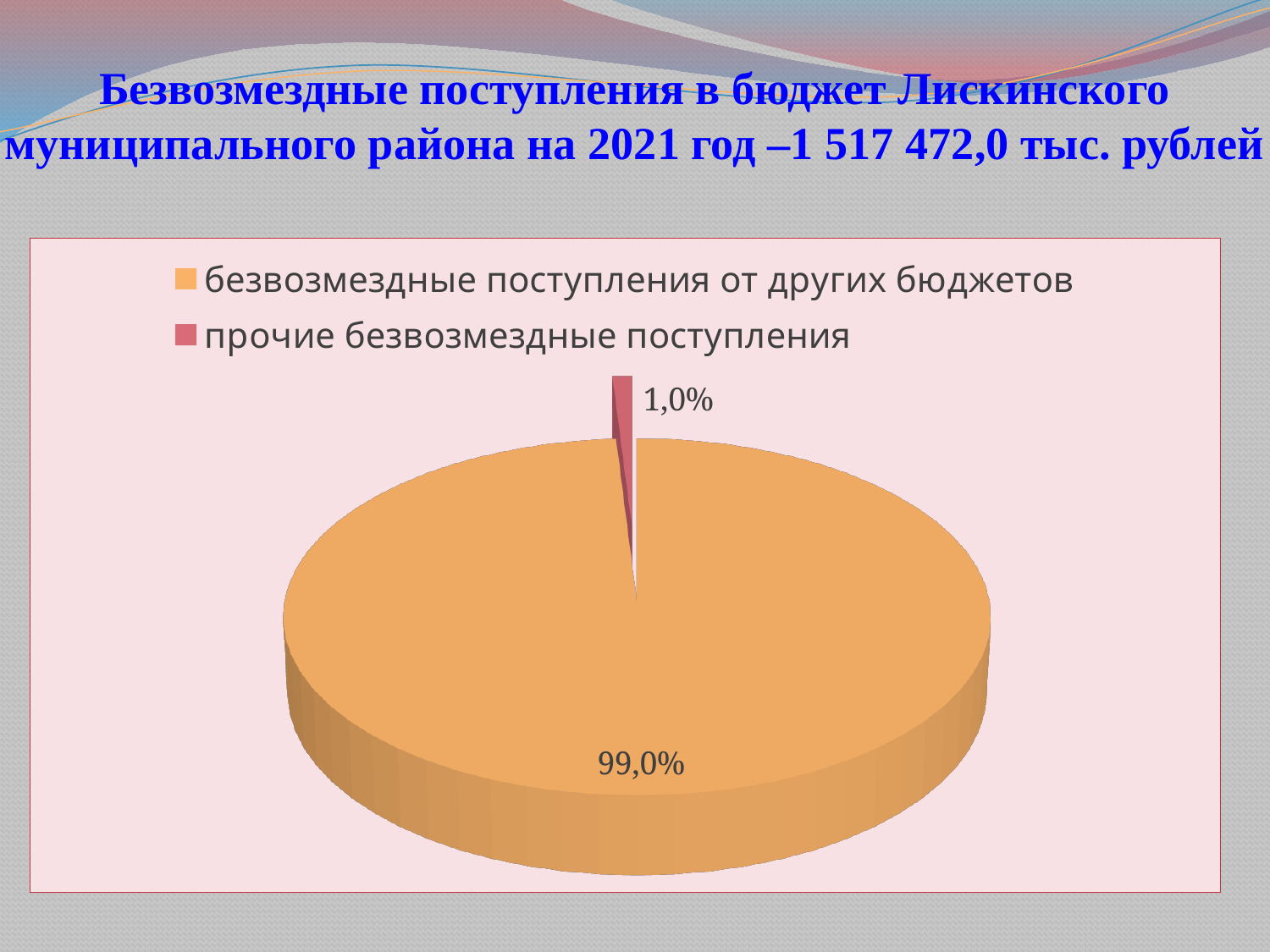
What kind of chart is shown on the slide? pie chart What total amount in thousand rubles is stated in the slide title for 2021? 1 517 472,0 тыс. рублей Which category has the largest slice of the pie? безвозмездные поступления от других бюджетов What share of the pie does 'безвозмездные поступления от других бюджетов' have? 99,0% What colour is the slice for 'прочие безвозмездные поступления'? red How many entries does the legend list? 2 Which is larger: the share of 'прочие безвозмездные поступления' or the share of 'безвозмездные поступления от других бюджетов'? безвозмездные поступления от других бюджетов How many slices does the pie chart have? 2 Which category has the smallest slice of the pie? прочие безвозмездные поступления What share of the pie does 'прочие безвозмездные поступления' have? 1,0% What is the difference in percentage points between the share of 'безвозмездные поступления от других бюджетов' and 'прочие безвозмездные поступления'? 98,0%